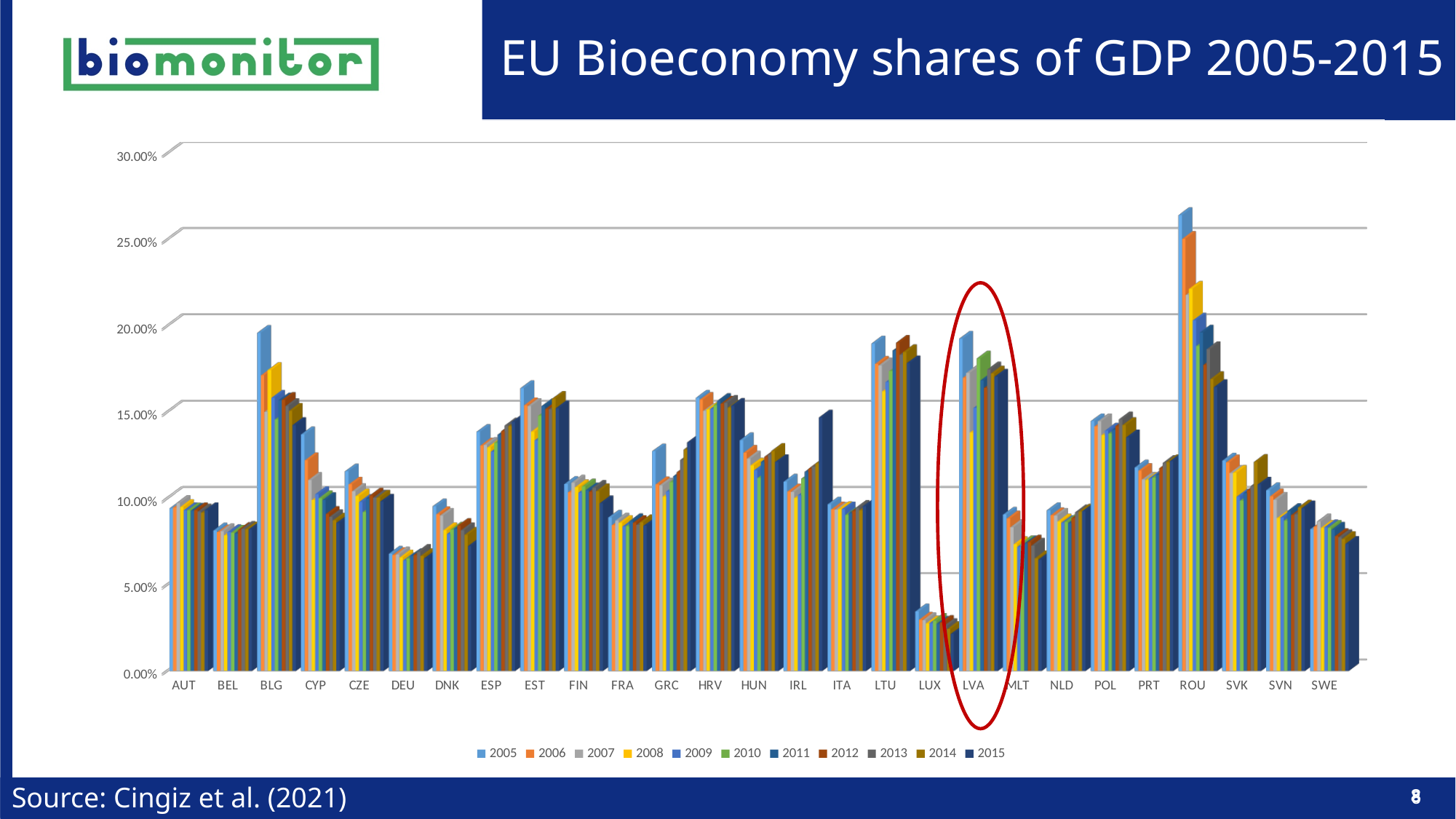
How many countries are shown on the x axis? 27 Is the value for BLG in 2005 greater or less than 15.00%? greater Is the value for DEU in 2015 greater or less than 10.00%? less What kind of chart is shown on the slide? bar chart Is the value for LUX in 2005 greater or less than 5.00%? less Which country has the lowest bioeconomy share of GDP in 2005? LUX What is the title of the chart on the slide? EU Bioeconomy shares of GDP 2005-2015 Which is larger, the 2015 value for DEU or the 2015 value for LUX? DEU Which country is circled in red on the chart? LVA Which country has the highest bioeconomy share of GDP in 2005? ROU How many series does the legend list? 11